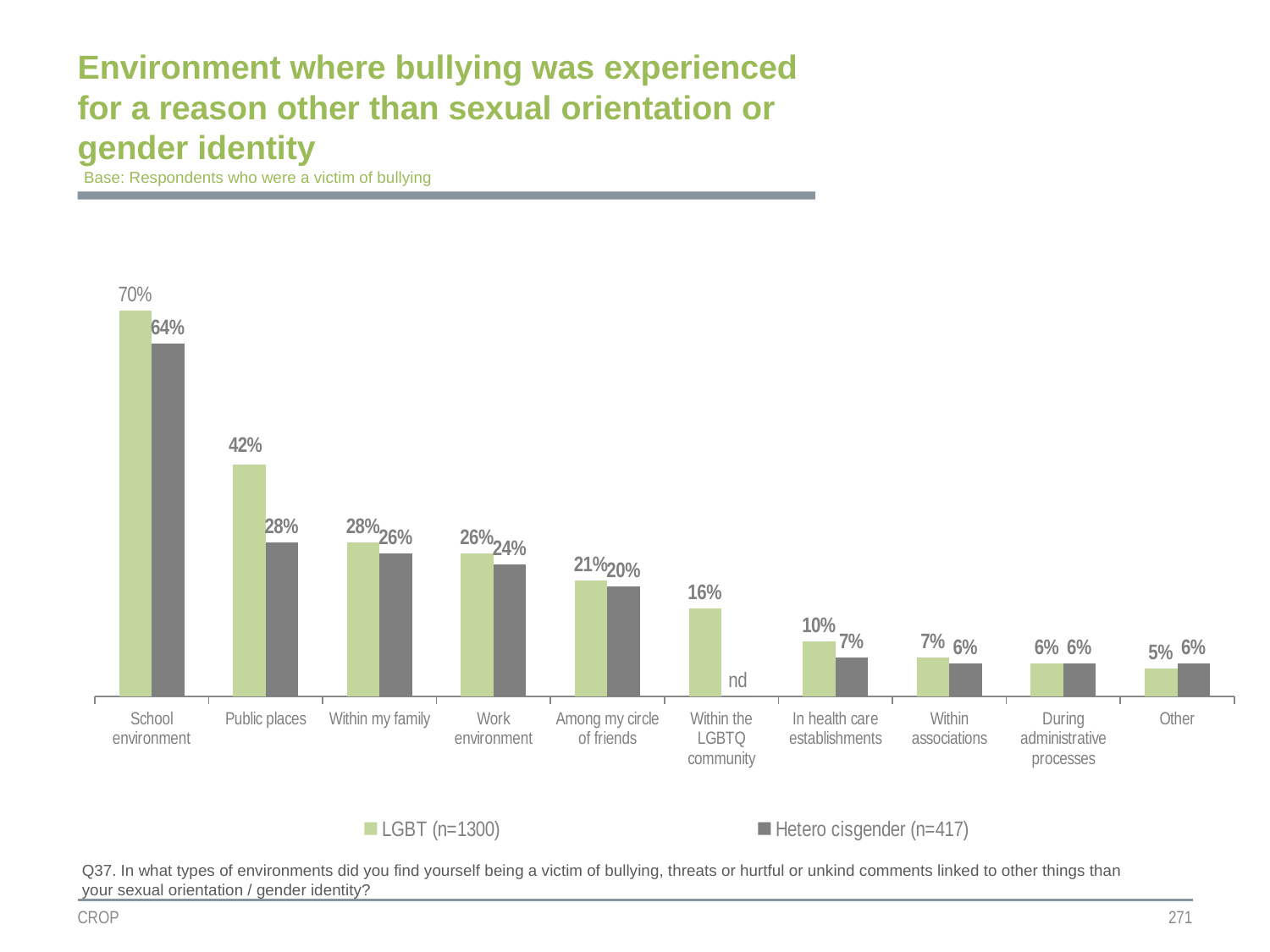
What kind of chart is shown on the slide? Bar chart What is the LGBT (n=1300) value for Within the LGBTQ community? 16% Which is larger for In health care establishments: the LGBT (n=1300) value or the Hetero cisgender (n=417) value? LGBT (n=1300) How many categories are shown on the x axis? 10 Which category has the highest LGBT (n=1300) value? School environment What is the Hetero cisgender (n=417) value for Public places? 28% What label is shown for the Hetero cisgender (n=417) value for Within the LGBTQ community? nd What is the base stated under the chart title? Respondents who were a victim of bullying How many series does the legend list? 2 Which category has the lowest LGBT (n=1300) value? Other What is the difference between the LGBT (n=1300) and Hetero cisgender (n=417) values for Public places? 14% What is the LGBT (n=1300) value for School environment? 70%